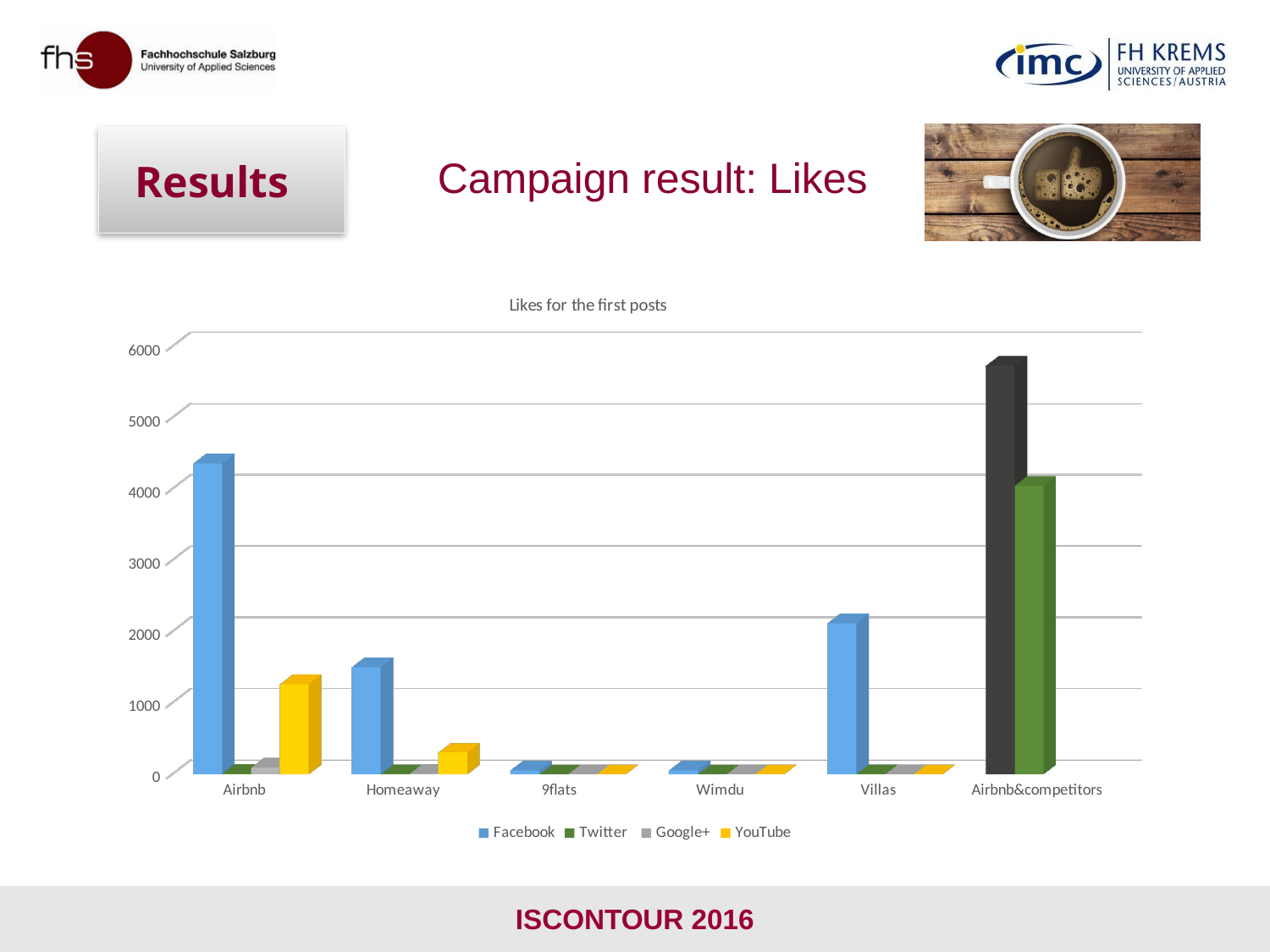
Is the YouTube value for Airbnb greater or less than 1000? greater What kind of chart is shown on the slide? bar chart What is the title of the chart? Likes for the first posts Is the Facebook value for Villas greater or less than 3000? less How many categories are shown on the x axis of the chart? 6 How many series does the chart's legend list? 4 Is the YouTube value for Homeaway greater or less than 1000? less Which category has the tallest bar in the chart? Airbnb&competitors Which series are listed in the chart's legend? Facebook, Twitter, Google+, YouTube Which has the larger Facebook value, Airbnb or Villas? Airbnb